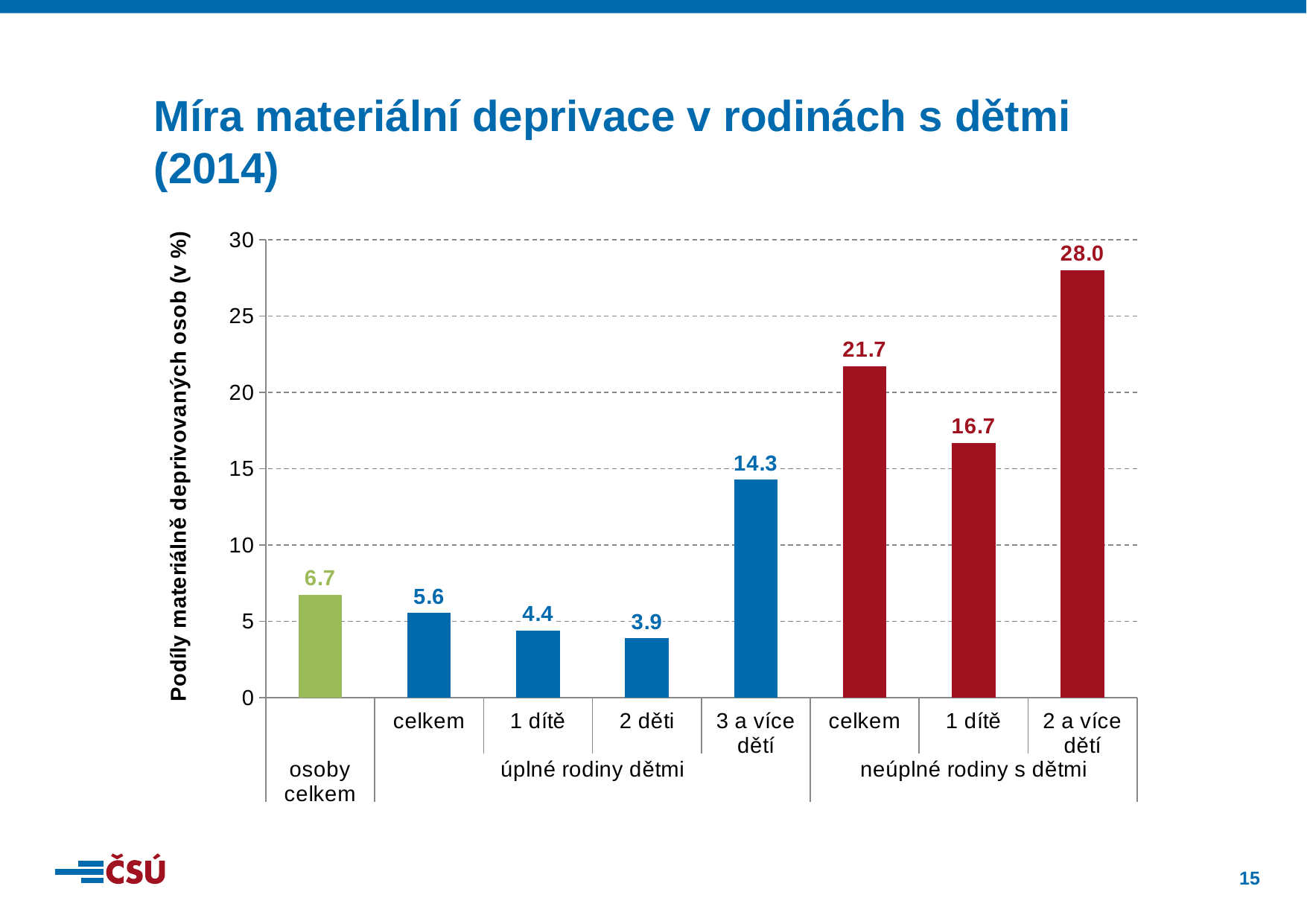
What kind of chart is shown? bar chart What is the difference between 'celkem' for neúplné rodiny s dětmi and 'celkem' for úplné rodiny dětmi? 16.1 What is the title of the chart? Míra materiální deprivace v rodinách s dětmi (2014) What colour are the bars for the 'neúplné rodiny s dětmi' group? red What is the value for 'osoby celkem'? 6.7 How many bars are plotted on the chart? 8 Which is larger: '1 dítě' in úplné rodiny dětmi or '2 děti' in úplné rodiny dětmi? 1 dítě What is the value for '3 a více dětí' in the 'úplné rodiny dětmi' group? 14.3 What is the value for '1 dítě' in the 'neúplné rodiny s dětmi' group? 16.7 Is the value for '2 a více dětí' in neúplné rodiny s dětmi greater or less than 25? greater Which category has the lowest value? 2 děti (úplné rodiny dětmi) Which category has the highest value? 2 a více dětí (neúplné rodiny s dětmi)